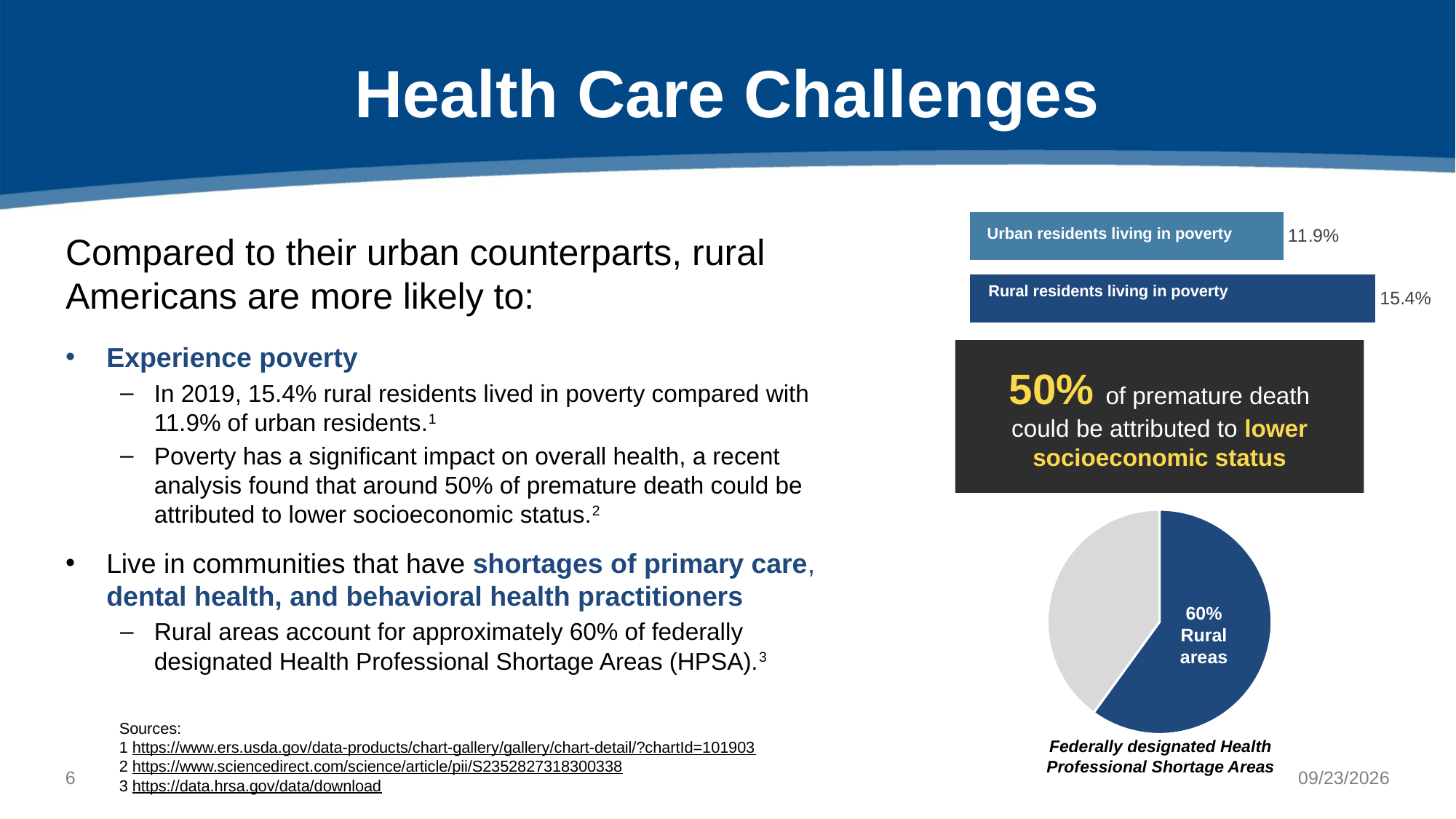
What kind of chart is used at the top right to show poverty rates for urban and rural residents? bar chart How many bars are shown in the bar chart at the top right? 2 How many slices does the pie chart at the bottom right have? 2 In the bar chart at the top right, which category has the lower poverty rate? Urban residents living in poverty In the bar chart at the top right, is the value for rural residents larger or smaller than the value for urban residents? larger What is the caption below the pie chart at the bottom right? Federally designated Health Professional Shortage Areas In the bar chart at the top right, what percentage of urban residents live in poverty? 11.9% In the bar chart at the top right, which category has the higher poverty rate? Rural residents living in poverty In the bar chart at the top right, what is the difference in percentage points between the rural and urban poverty rates? 3.5 percentage points What kind of chart is shown at the bottom right of the slide? pie chart In the pie chart at the bottom right, what share of federally designated Health Professional Shortage Areas is attributed to rural areas? 60% In the bar chart at the top right, what percentage of rural residents live in poverty? 15.4%